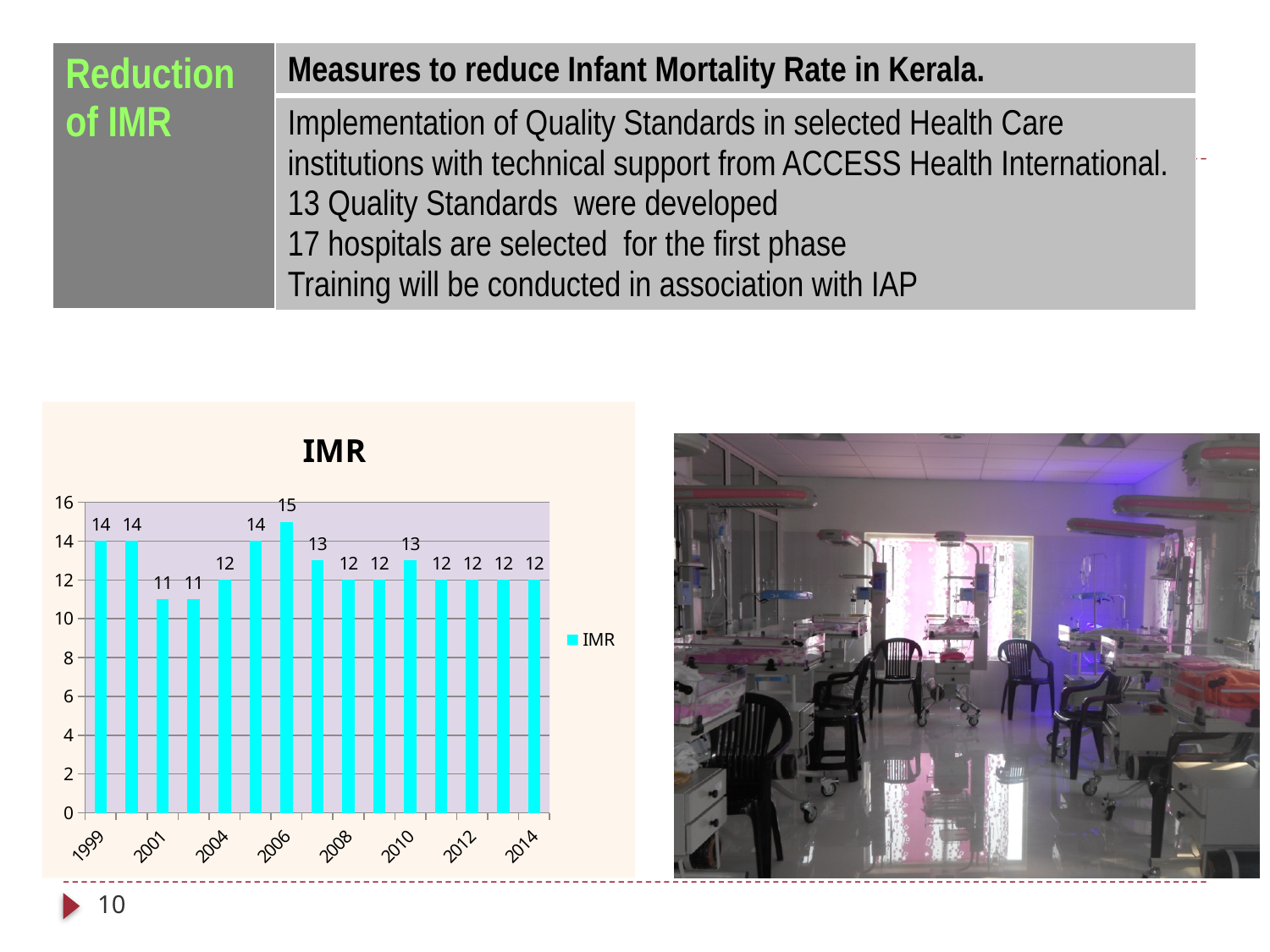
What is the difference between the IMR values for 2006 and 2001? 4 What is the IMR value for 2006? 15 How many bars are plotted in the IMR chart? 15 What is the IMR value for 2014? 12 What type of chart is used to show IMR? bar chart Which is larger, the IMR value for 1999 or for 2004? 1999 What is the IMR value for 1999? 14 What is the IMR value for 2010? 13 Which year has the highest IMR value? 2006 Is the IMR value for 2001 greater or less than 12? less What is the title of the chart? IMR What is the lowest IMR value shown in the chart? 11